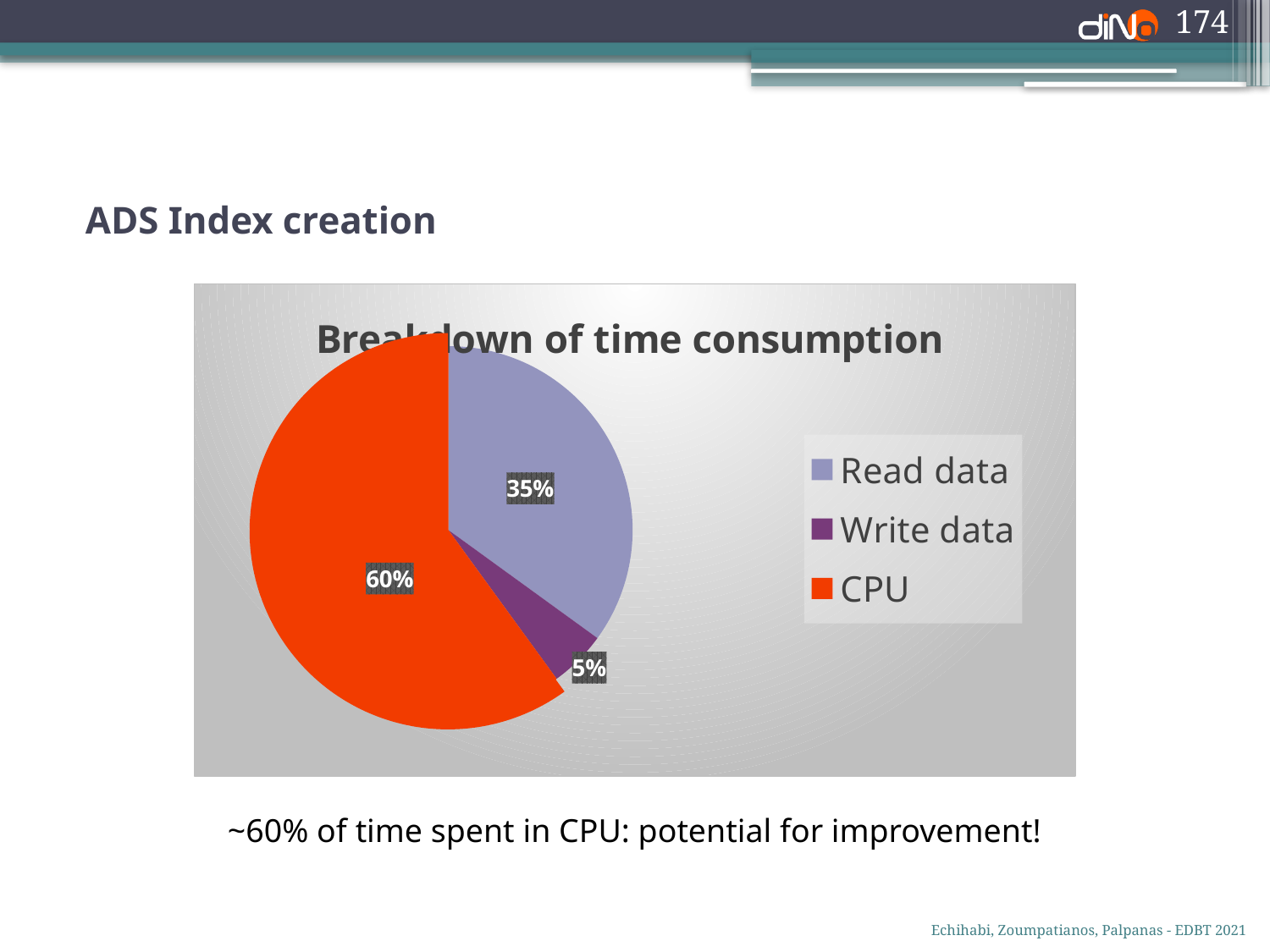
What share of time consumption is attributed to CPU? 60% What is the combined share of Read data and Write data? 40% What share of time consumption is attributed to Read data? 35% Which category accounts for the largest share of time consumption? CPU What colour represents CPU in the pie chart? orange-red What is the title of the chart? Breakdown of time consumption Which category accounts for the smallest share of time consumption? Write data What share of time consumption is attributed to Write data? 5% Which is larger, the share for Read data or the share for Write data? Read data How many categories does the pie chart show? 3 What kind of chart is shown on the slide? pie chart What is the difference in percentage points between the CPU share and the Read data share? 25